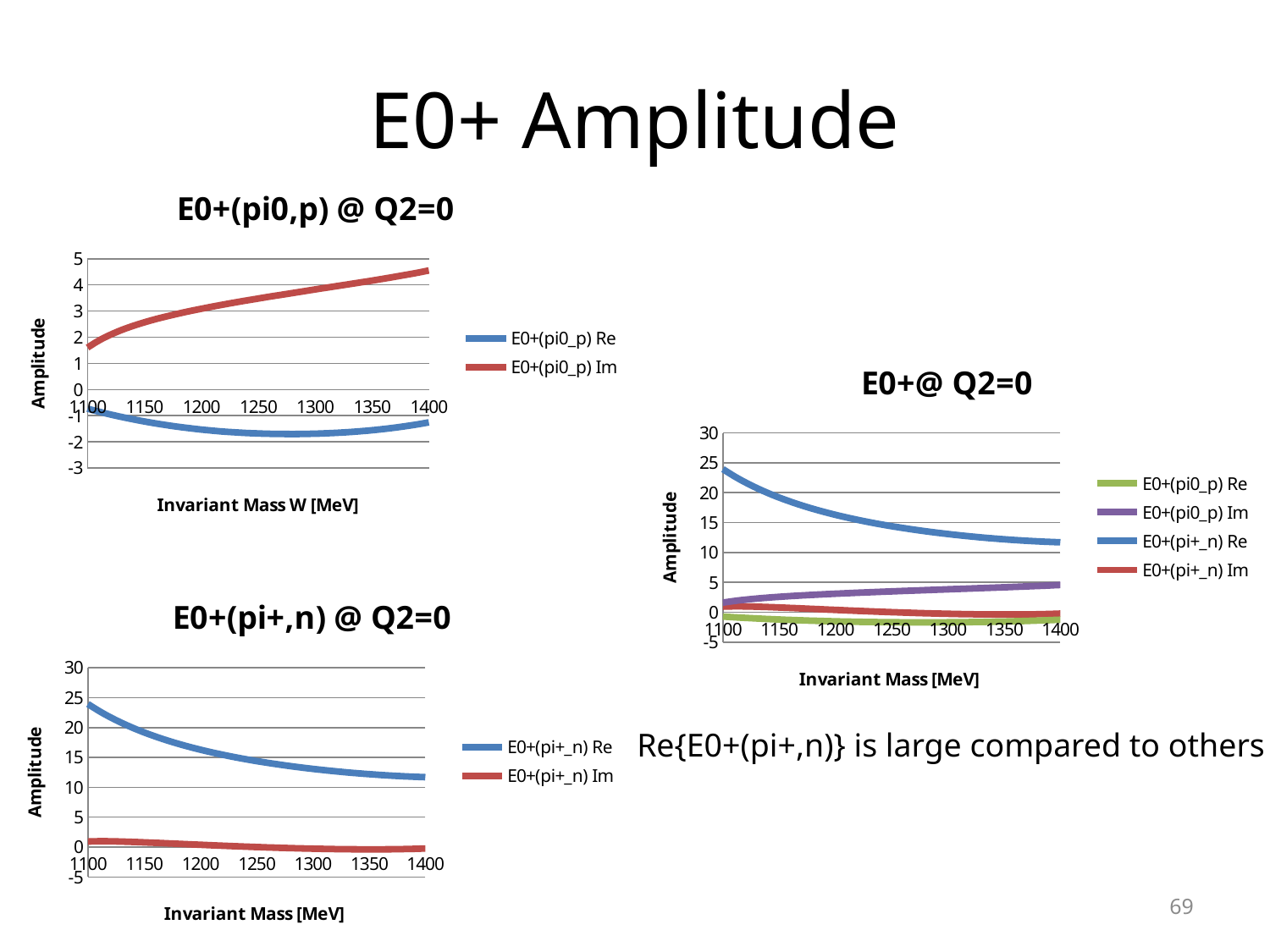
In the 'E0+(pi+,n) @ Q2=0' chart, which series has the larger value at 1200 MeV, E0+(pi+_n) Re or E0+(pi+_n) Im? E0+(pi+_n) Re What is the y-axis title of the 'E0+@ Q2=0' chart? Amplitude What kind of chart is the 'E0+(pi0,p) @ Q2=0' chart? line chart In the 'E0+@ Q2=0' chart, which series has the highest value at 1100 MeV? E0+(pi+_n) Re In the 'E0+(pi+,n) @ Q2=0' chart, is the value of E0+(pi+_n) Re at 1100 MeV greater or less than 20? greater In the 'E0+(pi+,n) @ Q2=0' chart, does the E0+(pi+_n) Re series rise or fall as invariant mass increases from 1100 to 1400? falls How many series does the legend of the 'E0+(pi0,p) @ Q2=0' chart list? 2 What is the x-axis title of the 'E0+(pi0,p) @ Q2=0' chart? Invariant Mass W [MeV] In the 'E0+(pi0,p) @ Q2=0' chart, does the E0+(pi0_p) Im series rise or fall as invariant mass increases from 1100 to 1400? rises In the 'E0+(pi0,p) @ Q2=0' chart, is the value of E0+(pi0_p) Im at 1400 MeV greater or less than 4? greater In the 'E0+(pi+,n) @ Q2=0' chart, is the value of E0+(pi+_n) Re at 1400 MeV greater or less than 15? less How many series does the legend of the 'E0+@ Q2=0' chart list? 4